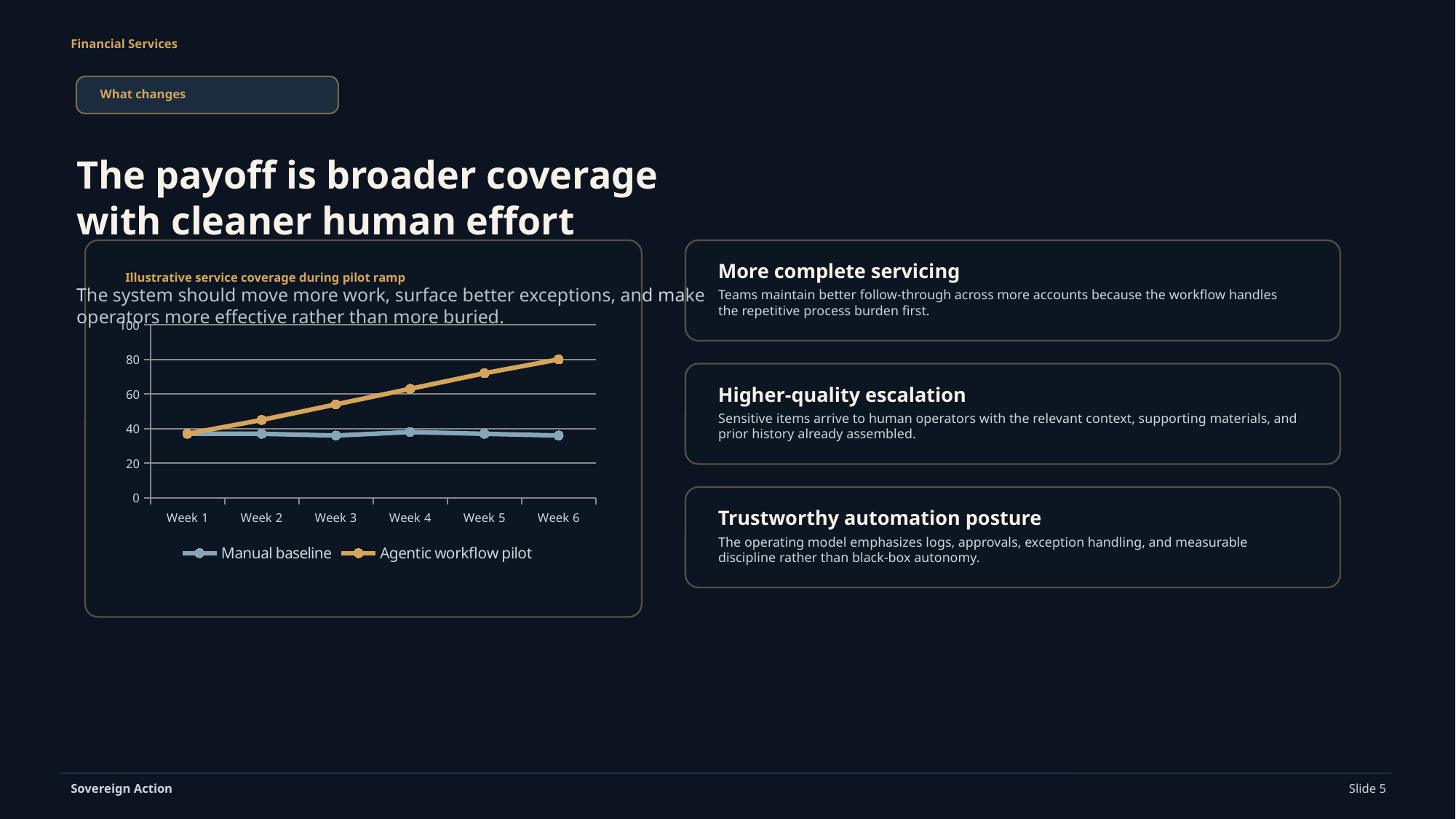
Which two series are listed in the chart legend? Manual baseline and Agentic workflow pilot How many weeks are plotted along the x axis of the chart? 6 Is the Manual baseline value at Week 4 greater or less than 60? less Is the Agentic workflow pilot value at Week 2 greater or less than 60? less In which week does the Agentic workflow pilot series reach its highest value? Week 6 At Week 6, which series has the larger value, Manual baseline or Agentic workflow pilot? Agentic workflow pilot What is the title of the chart? Illustrative service coverage during pilot ramp Is the Agentic workflow pilot value at Week 6 greater or less than 60? greater Does the Agentic workflow pilot series rise or fall from Week 1 to Week 6? rise In which week is the Agentic workflow pilot series at its lowest value? Week 1 How many series does the chart legend list? 2 What kind of chart is shown on the slide? line chart